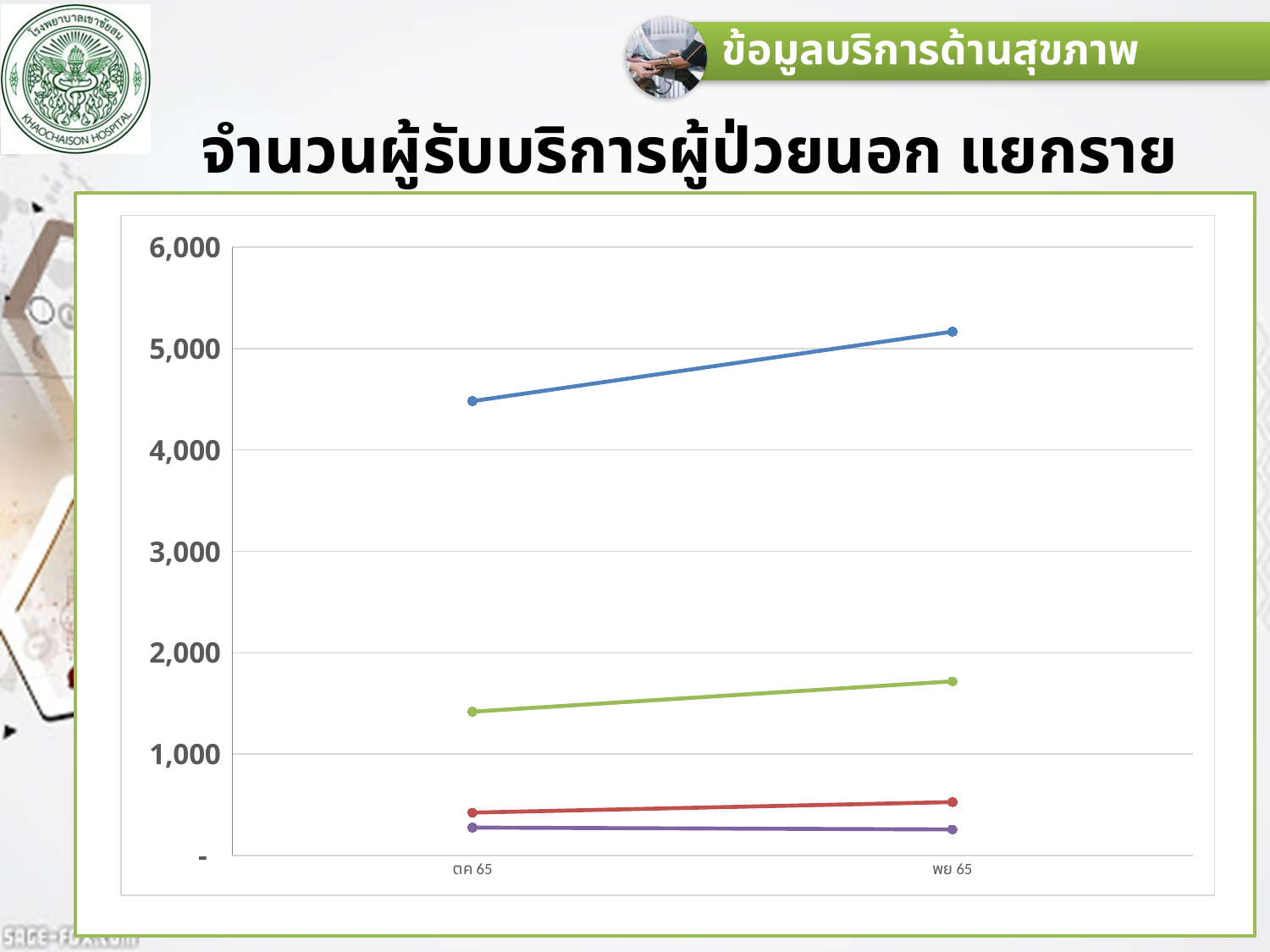
How many lines are plotted on the chart? 4 Which line has the lowest values on the chart? the purple line Which is larger at พย 65, the value of the green line or the value of the red line? the green line Does the blue line rise or fall from ตค 65 to พย 65? rise Is the value of the red line at พย 65 greater or less than 1,000? less Is the value of the green line at พย 65 greater or less than 1,000? greater Which line has the highest values on the chart? the blue line How many categories are shown on the x axis of the chart? 2 Is the value of the green line at ตค 65 greater or less than 2,000? less What kind of chart is shown on the slide? line chart